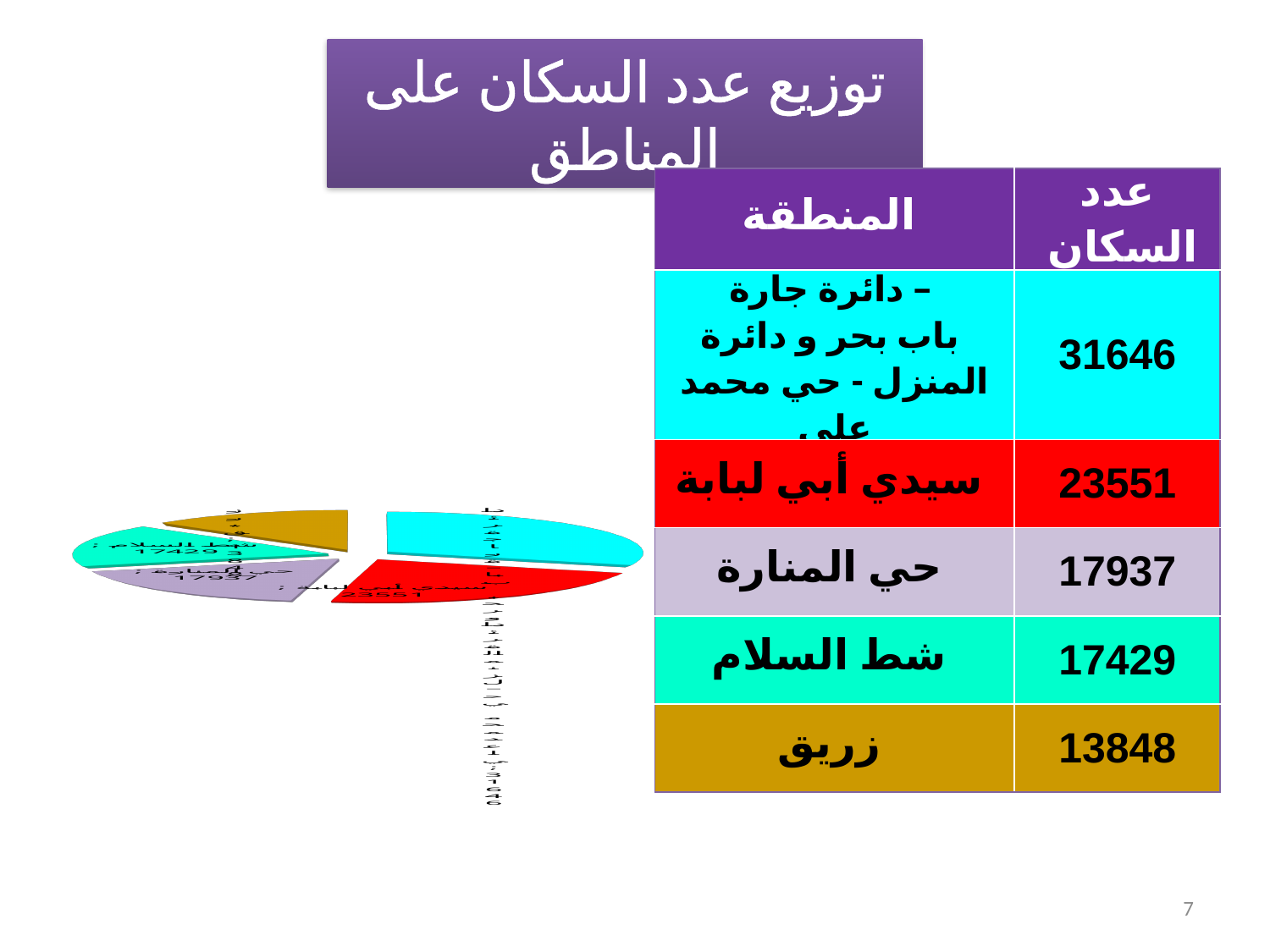
Which region is represented by the red slice of the pie chart? سيدي أبي لبابة Which has a larger population, حي المنارة or شط السلام? حي المنارة Which region has the largest slice of the pie chart? دائرة جارة باب بحر و دائرة المنزل - حي محمد علي What is the population value for زريق? 13848 What is the population value for شط السلام? 17429 What kind of chart is shown on the slide? pie chart Which region has the smallest slice of the pie chart? زريق What is the population value for سيدي أبي لبابة? 23551 How many slices does the pie chart have? 5 What is the difference between the population of حي المنارة and شط السلام? 508 What is the difference between the population of سيدي أبي لبابة and زريق? 9703 What is the population value for حي المنارة? 17937